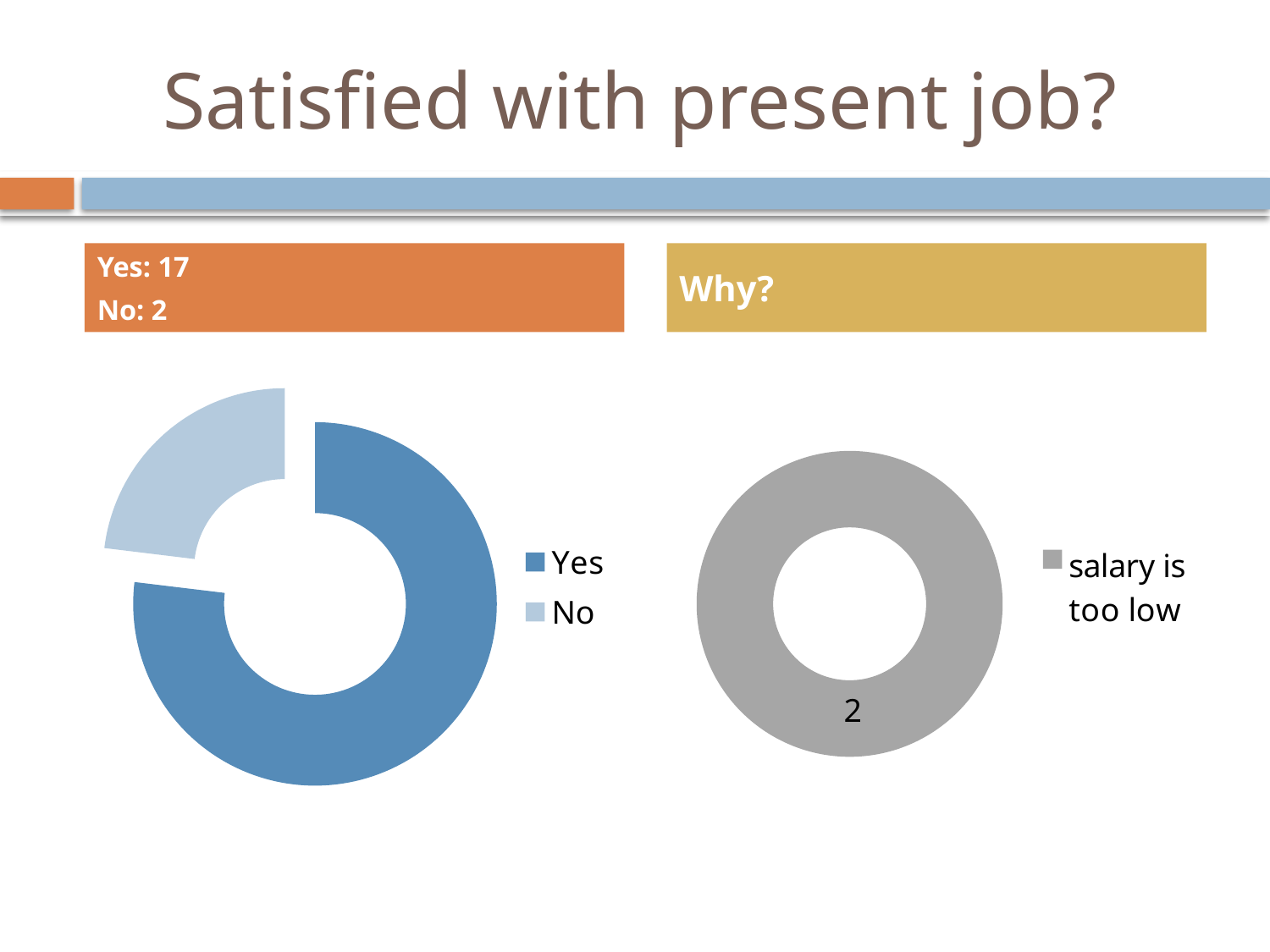
What kind of chart is the left chart on the slide? doughnut chart How many categories does the left chart show? 2 In the left chart, which is larger, Yes or No? Yes In the right chart, what value is shown for 'salary is too low'? 2 What is the only legend entry of the right chart? salary is too low In the left chart, which category is the smallest? No How many categories does the right chart show? 1 What kind of chart is the right chart, under the 'Why?' heading? doughnut chart In the left chart, which category is the largest? Yes